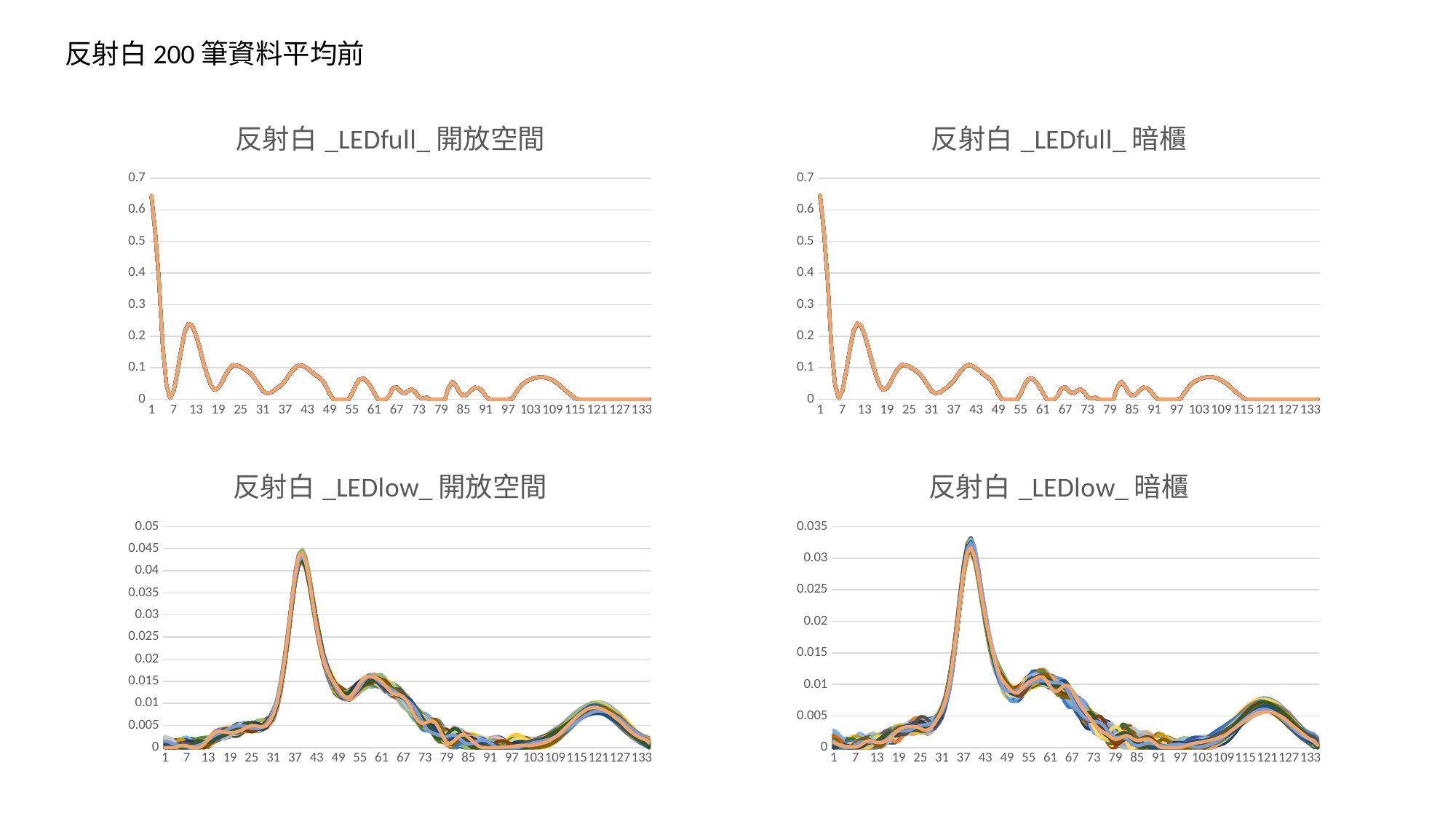
How many charts are shown on the slide? 4 In the chart 反射白 _LEDlow_ 暗櫃, is the highest peak greater or less than 0.03? greater What is the highest value shown on the y axis of the chart 反射白 _LEDlow_ 暗櫃? 0.035 In the chart 反射白 _LEDlow_ 開放空間, is the highest peak greater or less than 0.04? greater In the chart 反射白 _LEDfull_ 暗櫃, is the value at x = 13 greater or less than 0.2? greater What kind of chart is the top-left chart titled 反射白 _LEDfull_ 開放空間? line chart In the chart 反射白 _LEDfull_ 開放空間, do the values rise or fall from x = 1 to x = 7? fall In the chart 反射白 _LEDfull_ 暗櫃, which is larger, the value at x = 1 or the value at x = 13? x = 1 What is the title of the bottom-right chart? 反射白 _LEDlow_ 暗櫃